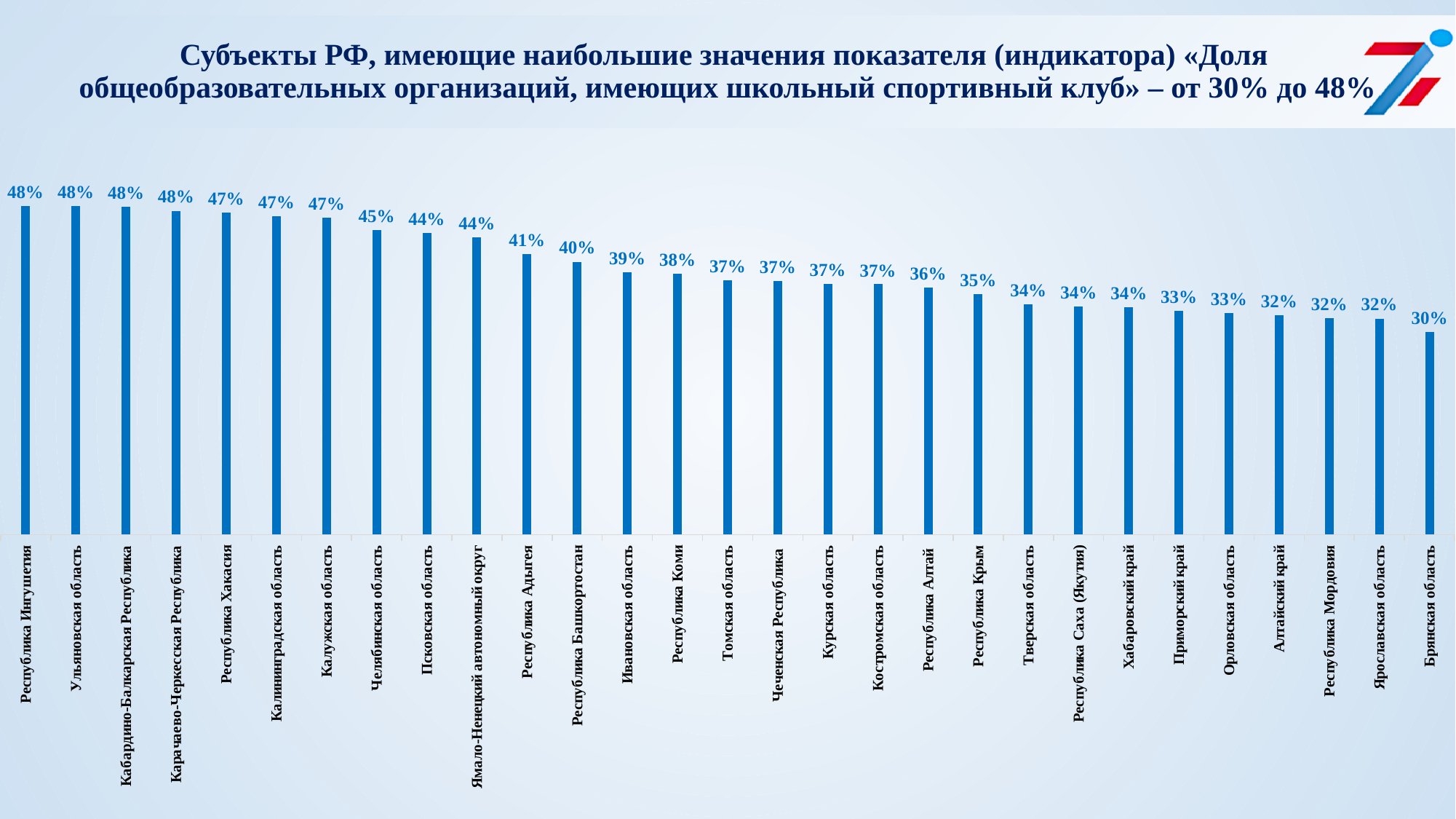
How many regions are shown on the chart? 29 Do the values rise or fall from left to right along the x axis? Fall What kind of chart is shown on the slide? Bar chart What is the value for Ямало-Ненецкий автономный округ? 44% Which has a larger value, Хабаровский край or Республика Алтай? Республика Алтай What is the value for Республика Крым? 35% What is the difference between the values for Республика Ингушетия and Брянская область? 18% Which region has the lowest value on the chart? Брянская область What is the value for Челябинская область? 45% What is the difference between the values for Республика Башкортостан and Республика Коми? 2% What is the value for Республика Адыгея? 41% Which has a larger value, Псковская область or Ивановская область? Псковская область